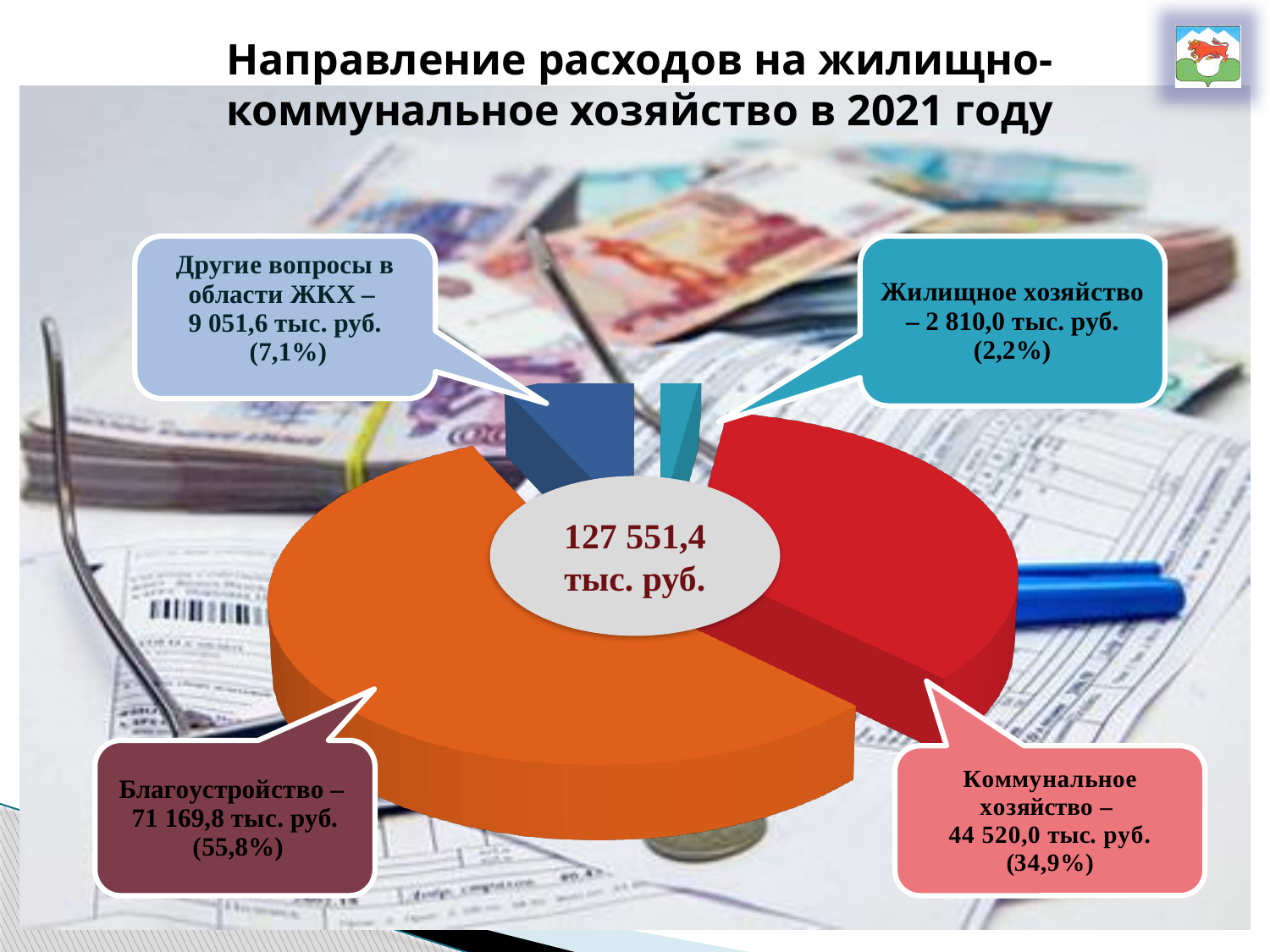
What is the value for Жилищное хозяйство? 2 810,0 тыс. руб. What share of the pie does Другие вопросы в области ЖКХ represent? 7,1% Which is larger, the value for Другие вопросы в области ЖКХ or the value for Жилищное хозяйство? Другие вопросы в области ЖКХ Which category has the smallest share of the pie? Жилищное хозяйство What is the value for Благоустройство? 71 169,8 тыс. руб. What kind of chart is shown on the slide? pie chart How many categories does the pie chart show? 4 What total value is shown in the centre of the pie chart? 127 551,4 тыс. руб. What share of the pie does Коммунальное хозяйство represent? 34,9% What is the value for Коммунальное хозяйство? 44 520,0 тыс. руб. What is the value for Другие вопросы в области ЖКХ? 9 051,6 тыс. руб. Which category has the largest share of the pie? Благоустройство